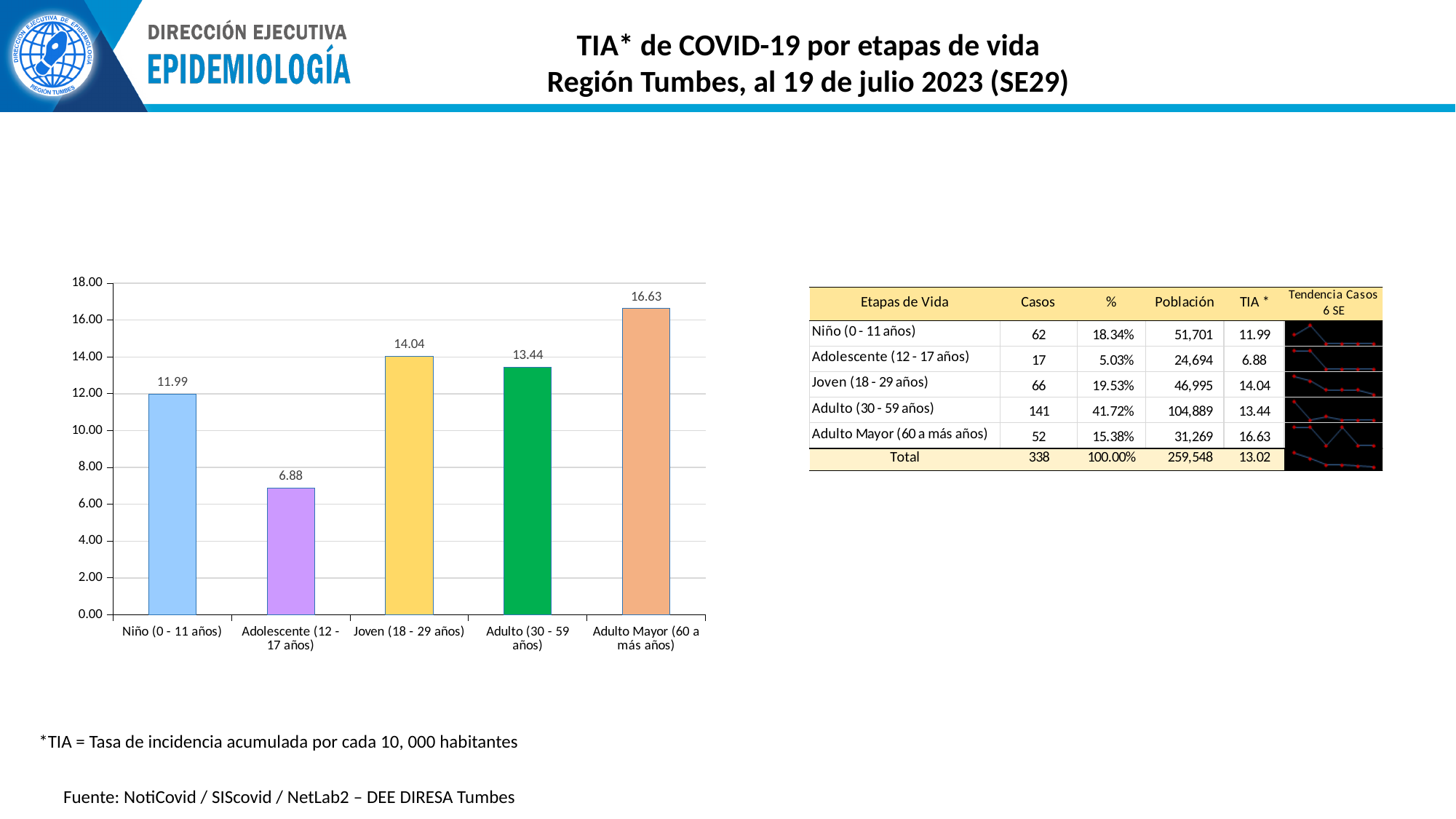
How many life-stage categories are shown in the bar chart? 5 What is the TIA value for Joven (18 - 29 años) in the bar chart? 14.04 What is the TIA value for Niño (0 - 11 años) in the bar chart? 11.99 What is the TIA value for Adolescente (12 - 17 años) in the bar chart? 6.88 What kind of chart is used to show TIA by life stage? Bar chart Is the TIA value for Niño (0 - 11 años) greater or less than 10.00? greater Which life stage has the lowest TIA in the bar chart? Adolescente (12 - 17 años) What is the maximum value shown on the y axis of the bar chart? 18.00 What is the TIA value for Adulto Mayor (60 a más años) in the bar chart? 16.63 What is the difference between the TIA for Adulto Mayor (60 a más años) and Adolescente (12 - 17 años)? 9.75 Which has a higher TIA in the bar chart, Joven (18 - 29 años) or Adulto (30 - 59 años)? Joven (18 - 29 años) Which life stage has the highest TIA in the bar chart? Adulto Mayor (60 a más años)